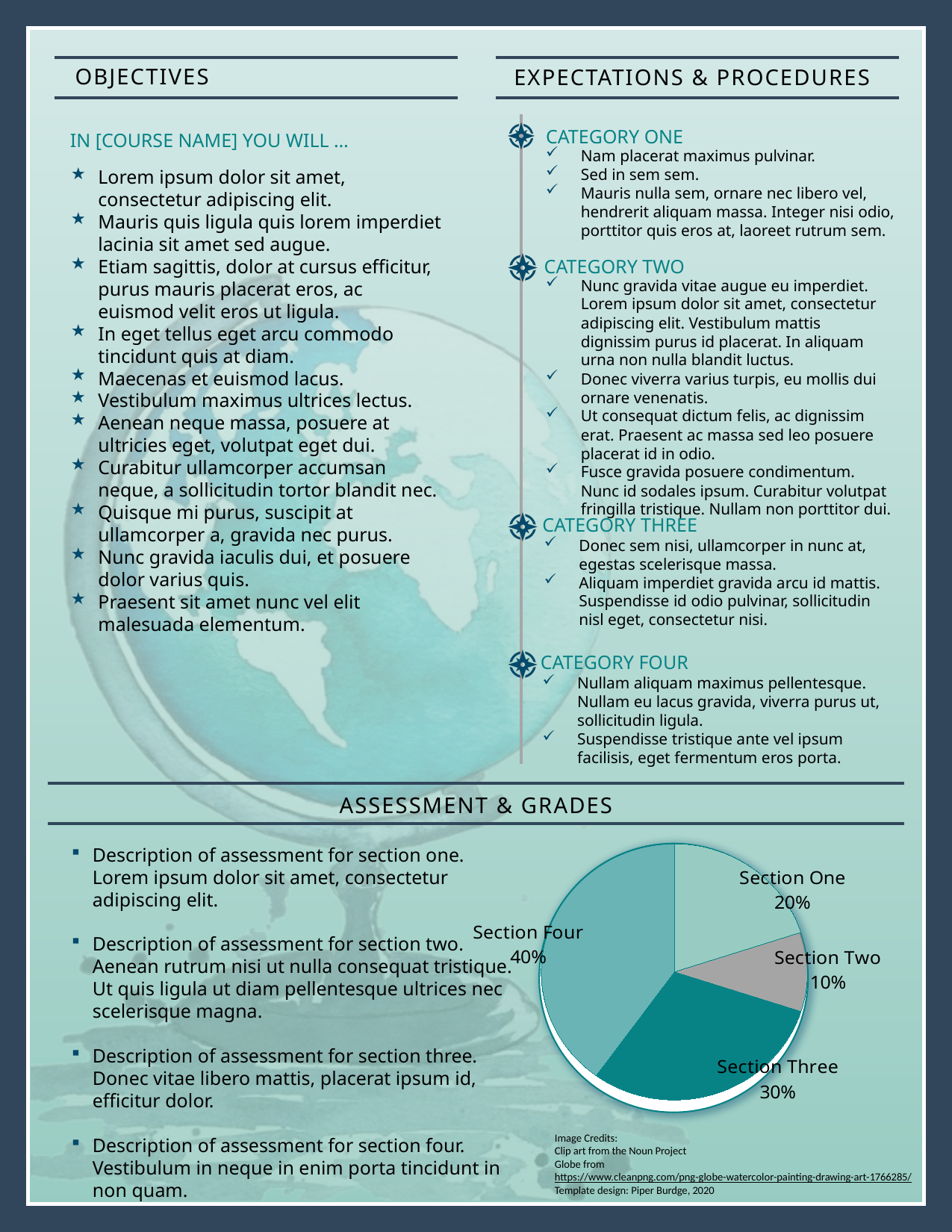
Which section has the largest slice of the pie chart? Section Four What share of the pie chart does Section Three represent? 30% What share of the pie chart does Section One represent? 20% What kind of chart is shown in the Assessment & Grades section? pie chart Which is larger in the pie chart, Section Three or Section Two? Section Three What share of the pie chart does Section Four represent? 40% Under which heading of the slide does the pie chart appear? Assessment & Grades How many slices does the pie chart have? 4 Which section has the smallest slice of the pie chart? Section Two What share of the pie chart does Section Two represent? 10% What is the difference in percentage points between Section Four and Section One in the pie chart? 20 What is the combined share of Section One and Section Three in the pie chart? 50%